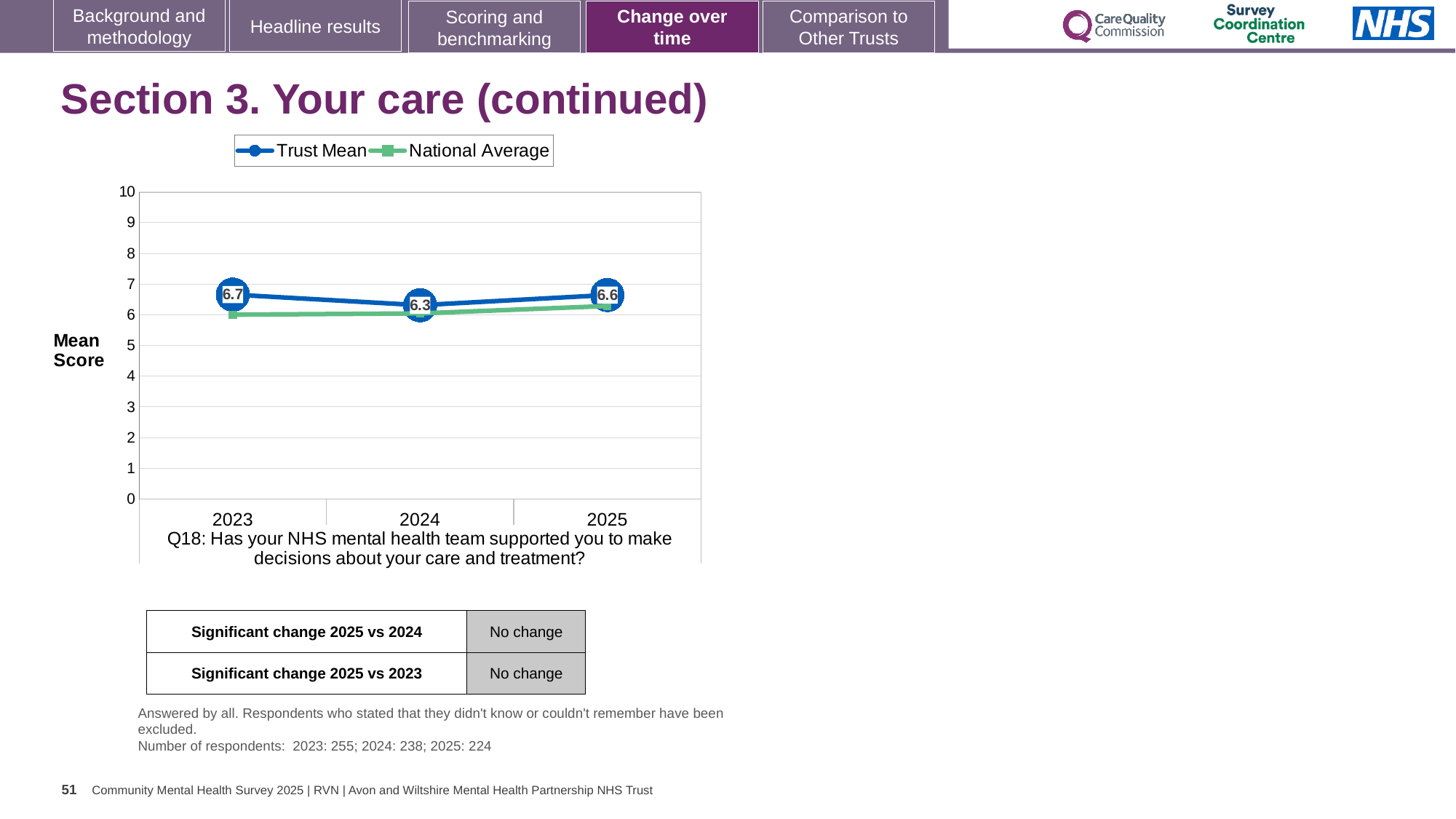
Does the Trust Mean rise or fall from 2023 to 2024? fall How many series does the legend list? 2 What is the Trust Mean value for 2025? 6.6 In which year is the Trust Mean lowest? 2024 In which year is the Trust Mean highest? 2023 What is the Trust Mean value for 2024? 6.3 Which is larger, the Trust Mean in 2025 or the Trust Mean in 2024? 2025 What is the difference between the Trust Mean in 2023 and in 2024? 0.4 What is the Trust Mean value for 2023? 6.7 Is the National Average value for 2023 greater or less than 7? less What kind of chart is shown on the slide? line chart How many years are plotted on the x axis? 3